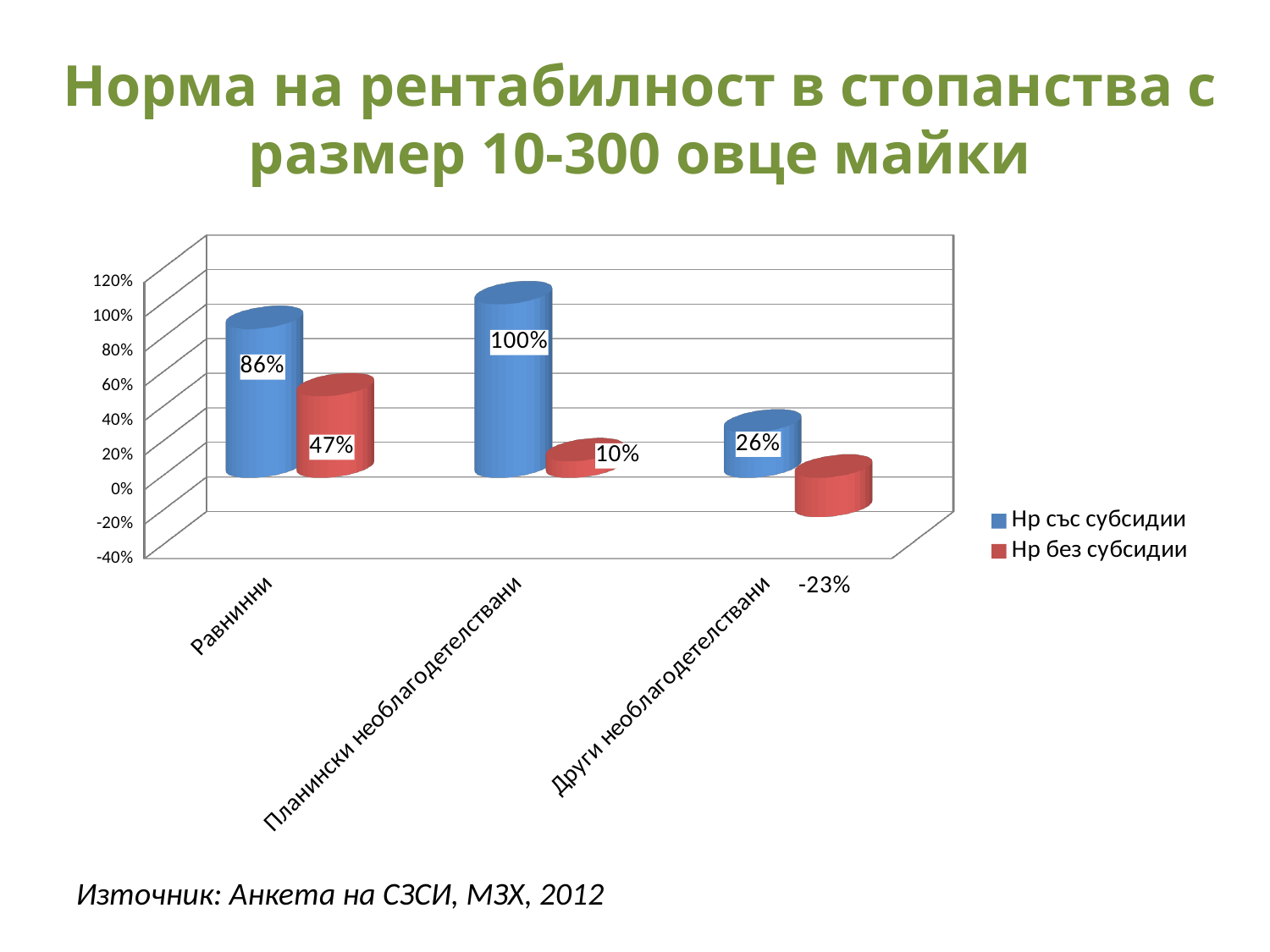
How many categories are shown on the x axis? 3 What is the value of 'Нр без субсидии' for 'Планински необлагодетелствани'? 10% Which category has the lowest value for 'Нр без субсидии'? Други необлагодетелствани How many series does the legend list? 2 What is the value of 'Нр без субсидии' for 'Други необлагодетелствани'? -23% Which category has the highest value for 'Нр със субсидии'? Планински необлагодетелствани What kind of chart is shown on the slide? Bar chart What colour represents the 'Нр без субсидии' series? Red What is the value of 'Нр със субсидии' for 'Равнинни'? 86% Which is larger for 'Планински необлагодетелствани': 'Нр със субсидии' or 'Нр без субсидии'? Нр със субсидии What is the difference between 'Нр със субсидии' and 'Нр без субсидии' for 'Равнинни'? 39% What is the value of 'Нр със субсидии' for 'Други необлагодетелствани'? 26%